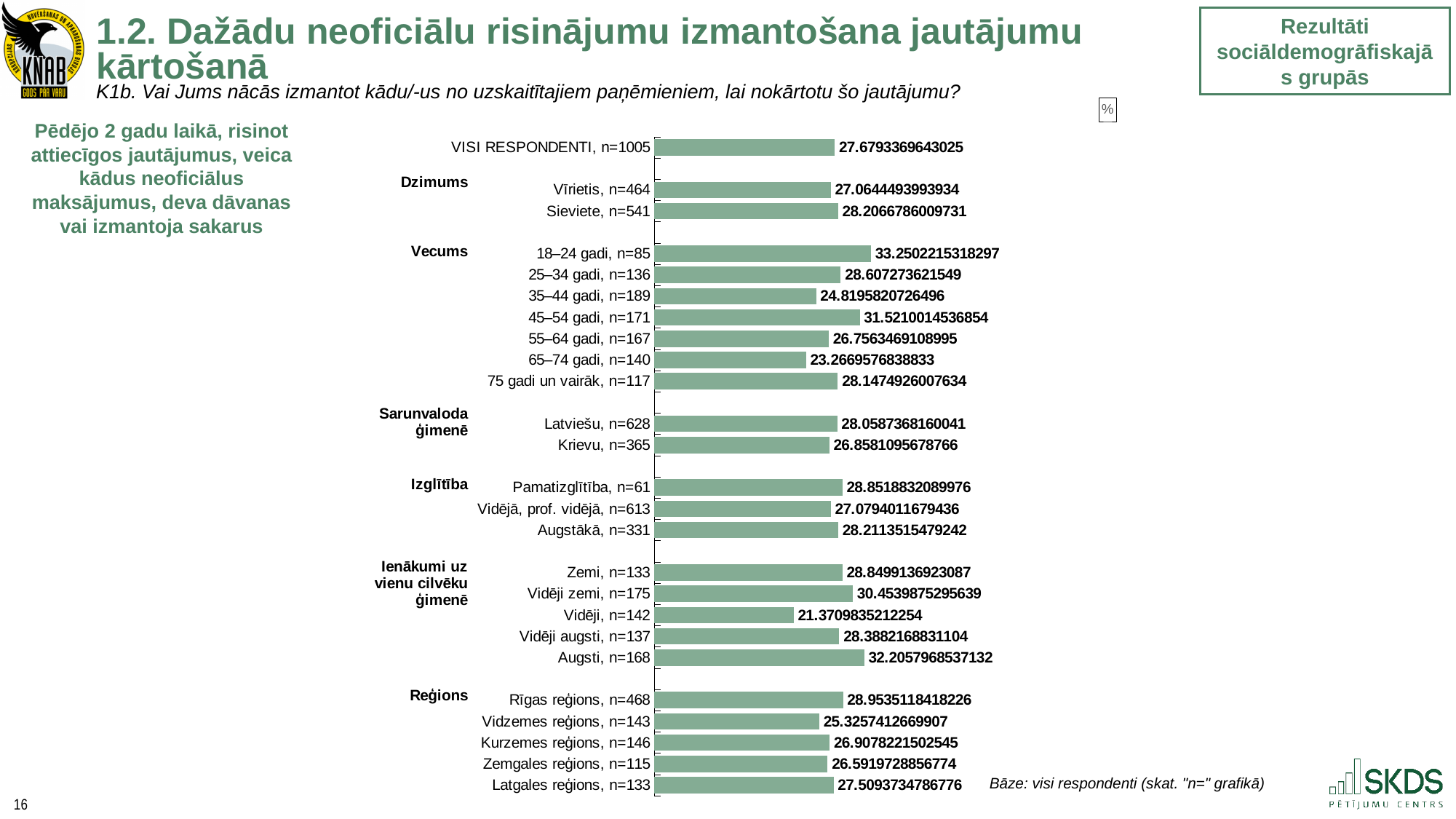
Which has the larger value, 45–54 gadi, n=171 or 65–74 gadi, n=140? 45–54 gadi, n=171 What unit is indicated for the values in the chart? % Which has the larger value, Vīrietis, n=464 or Sieviete, n=541? Sieviete, n=541 Which category has the highest value in the chart? 18–24 gadi, n=85 How many bars are plotted in the chart? 25 What is the difference between the values for Augsti, n=168 and Vidēji, n=142? 10.8348133324878 What is the value for 18–24 gadi, n=85? 33.2502215318297 What is the value for VISI RESPONDENTI, n=1005? 27.6793369643025 What is the value for Rīgas reģions, n=468? 28.9535118418226 What kind of chart is shown on the slide? Bar chart What is the value for Vidēji, n=142? 21.3709835212254 Which category has the lowest value in the chart? Vidēji, n=142